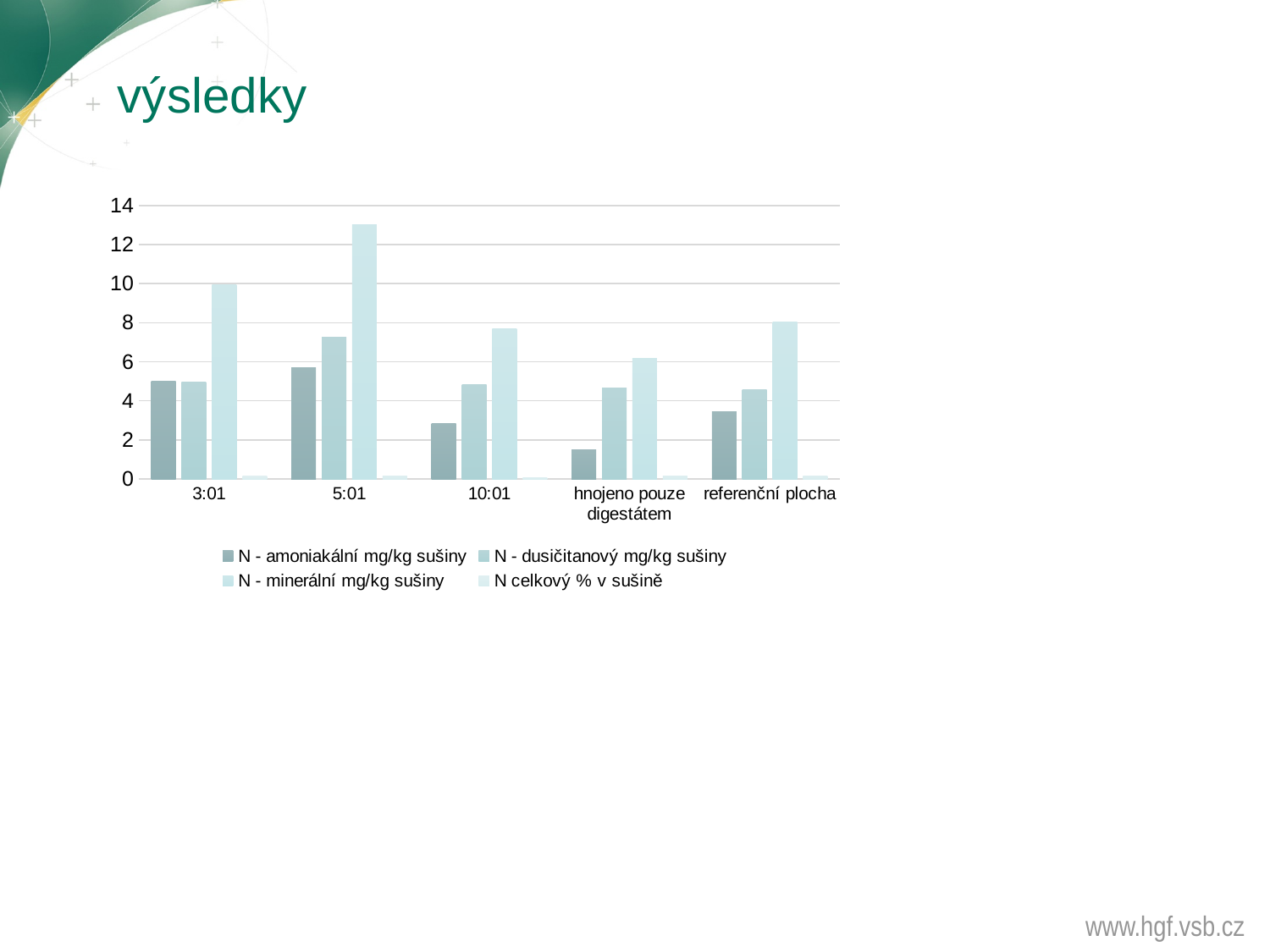
Is the value for N - minerální mg/kg sušiny at referenční plocha greater or less than 6? greater Which is larger for N - amoniakální mg/kg sušiny: 5:01 or hnojeno pouze digestátem? 5:01 Which is larger at 3:01: N - amoniakální mg/kg sušiny or N - minerální mg/kg sušiny? N - minerální mg/kg sušiny Which category has the highest value for N - dusičitanový mg/kg sušiny? 5:01 Is the value for N - minerální mg/kg sušiny at 5:01 greater or less than 12? greater What kind of chart is shown on the slide? bar chart Is the value for N - amoniakální mg/kg sušiny at 10:01 greater or less than 4? less What is the title of the slide containing the chart? výsledky Which category has the lowest value for N - amoniakální mg/kg sušiny? hnojeno pouze digestátem Which category has the highest value for N - minerální mg/kg sušiny? 5:01 How many categories are shown on the x axis of the chart? 5 How many series does the chart's legend list? 4